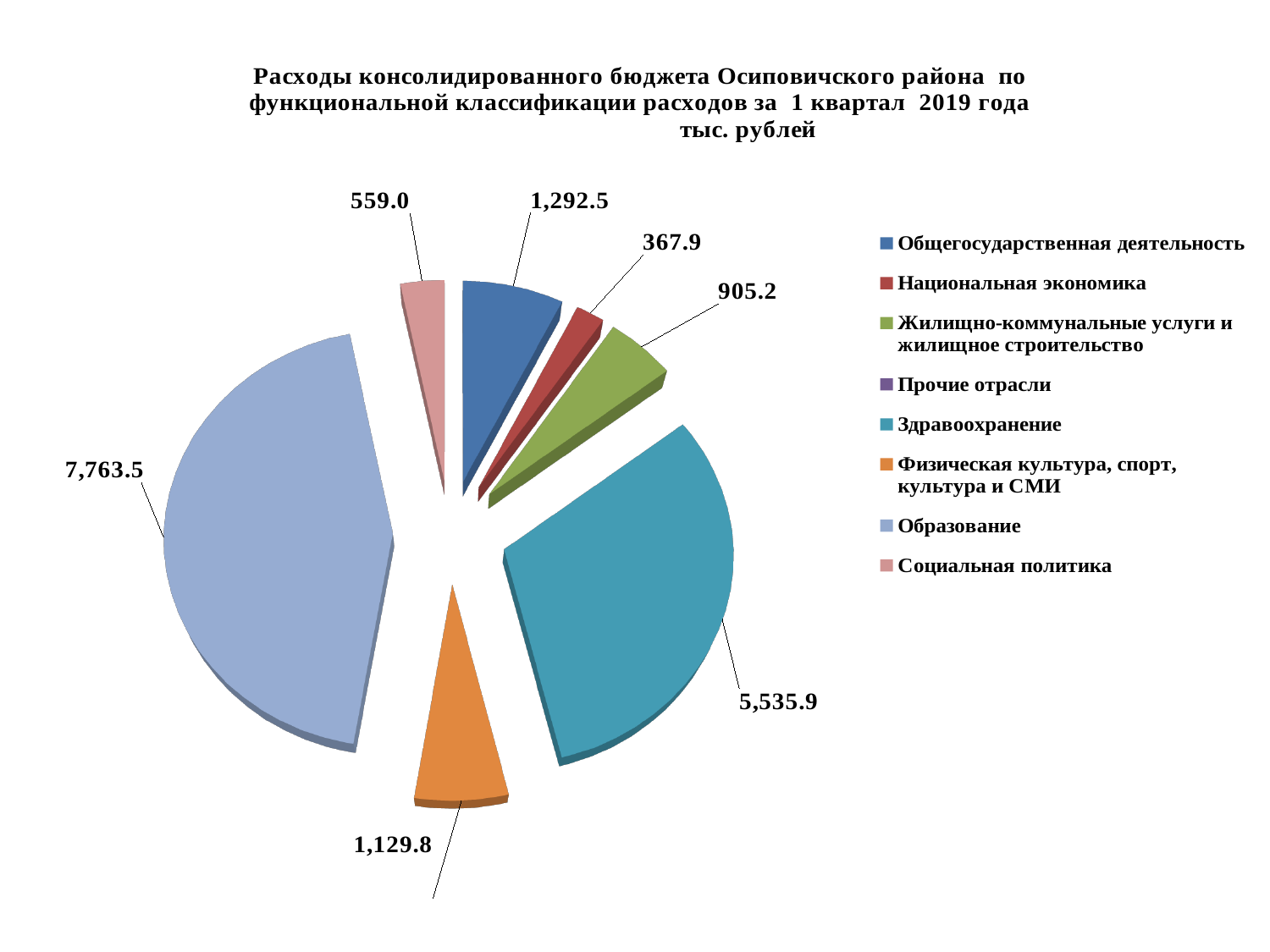
What is the value for Образование? 7,763.5 What is the value for Национальная экономика? 367.9 What is the value for Социальная политика? 559.0 How many entries does the legend list? 8 What type of chart is shown on the slide? Pie chart Which labelled category has the smallest value? Национальная экономика In what units are the values on the chart expressed, according to the title? тыс. рублей Which is larger, the value for Общегосударственная деятельность or the value for Жилищно-коммунальные услуги и жилищное строительство? Общегосударственная деятельность What is the difference between the values for Образование and Здравоохранение? 2,227.6 What is the value for Здравоохранение? 5,535.9 What is the value for Физическая культура, спорт, культура и СМИ? 1,129.8 Which category has the largest slice of the pie? Образование